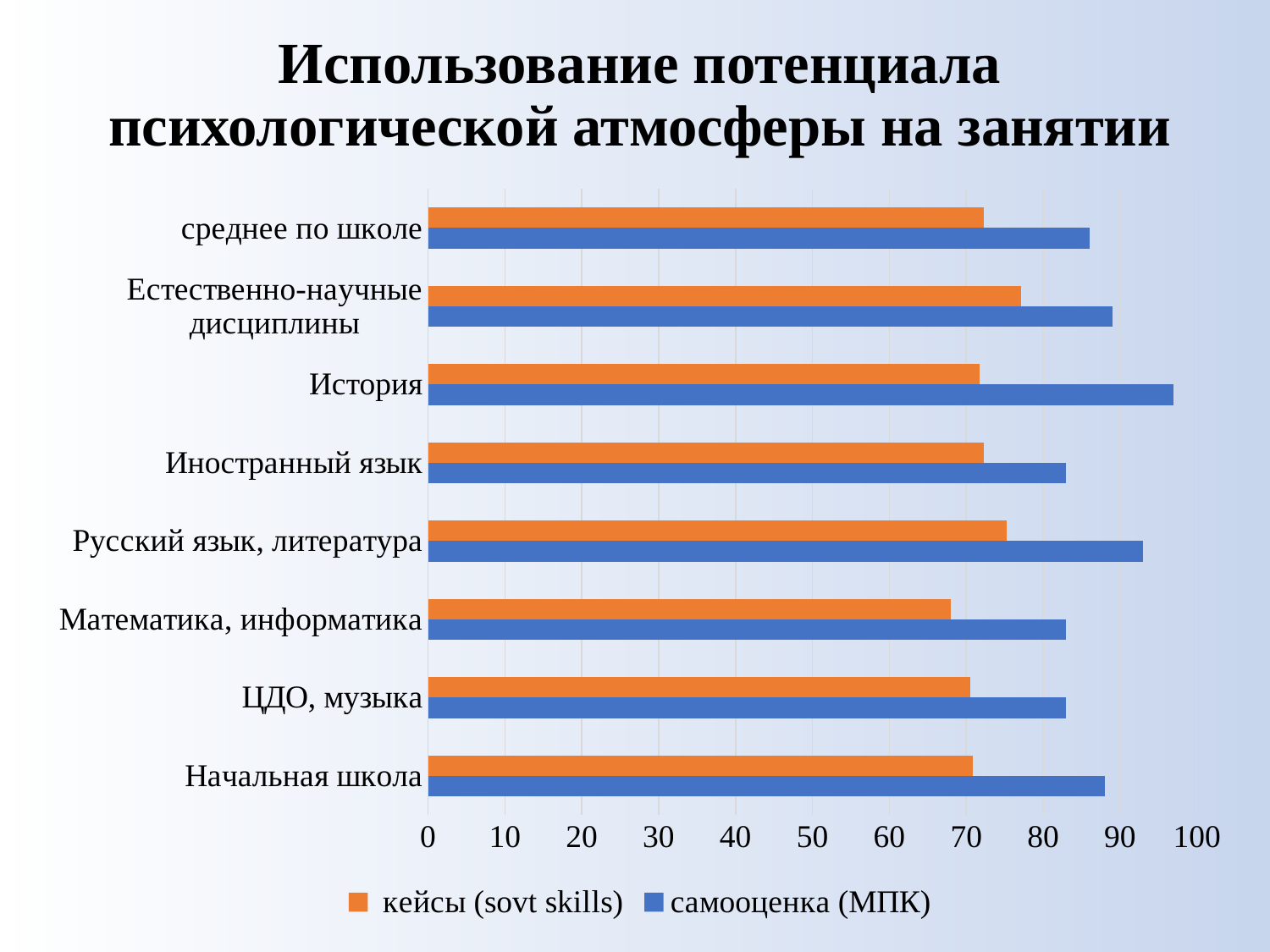
What kind of chart is shown on the slide? bar chart Which colour represents the series кейсы (sovt skills)? orange Is the value for самооценка (МПК) for Русский язык, литература greater or less than 90? greater How many categories are shown on the chart? 8 Is the value for кейсы (sovt skills) for Математика, информатика greater or less than 70? less For История, which series has the larger value: кейсы (sovt skills) or самооценка (МПК)? самооценка (МПК) Is the value for кейсы (sovt skills) for Естественно-научные дисциплины greater or less than 70? greater How many series does the legend list? 2 Which is larger: самооценка (МПК) for История or самооценка (МПК) for Иностранный язык? История Which category has the highest value for самооценка (МПК)? История